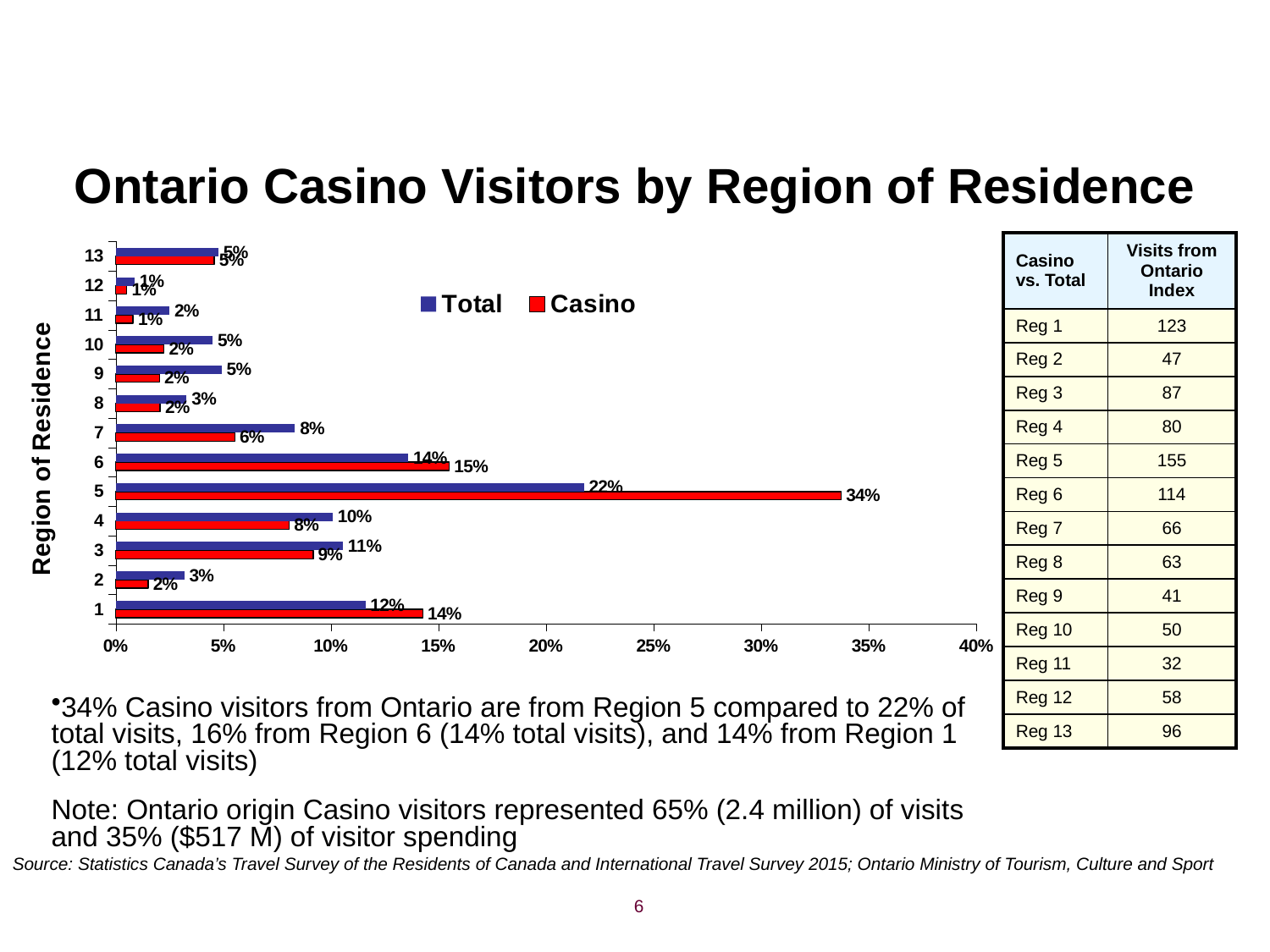
Which is larger for Region 7, the Total value or the Casino value? Total Which region has the lowest Total value? Region 12 What kind of chart is shown on the slide? Bar chart How many series does the chart legend list? 2 What colour are the Casino bars in the chart? Red What is the Casino value for Region 3? 9% What is the difference between the Casino and Total values for Region 5? 12% What is the Casino value for Region 5? 34% Is the Casino value for Region 5 greater or less than 30%? greater How many regions are shown on the y axis of the chart? 13 What is the Total value for Region 1? 12% Which region has the highest Casino value? Region 5